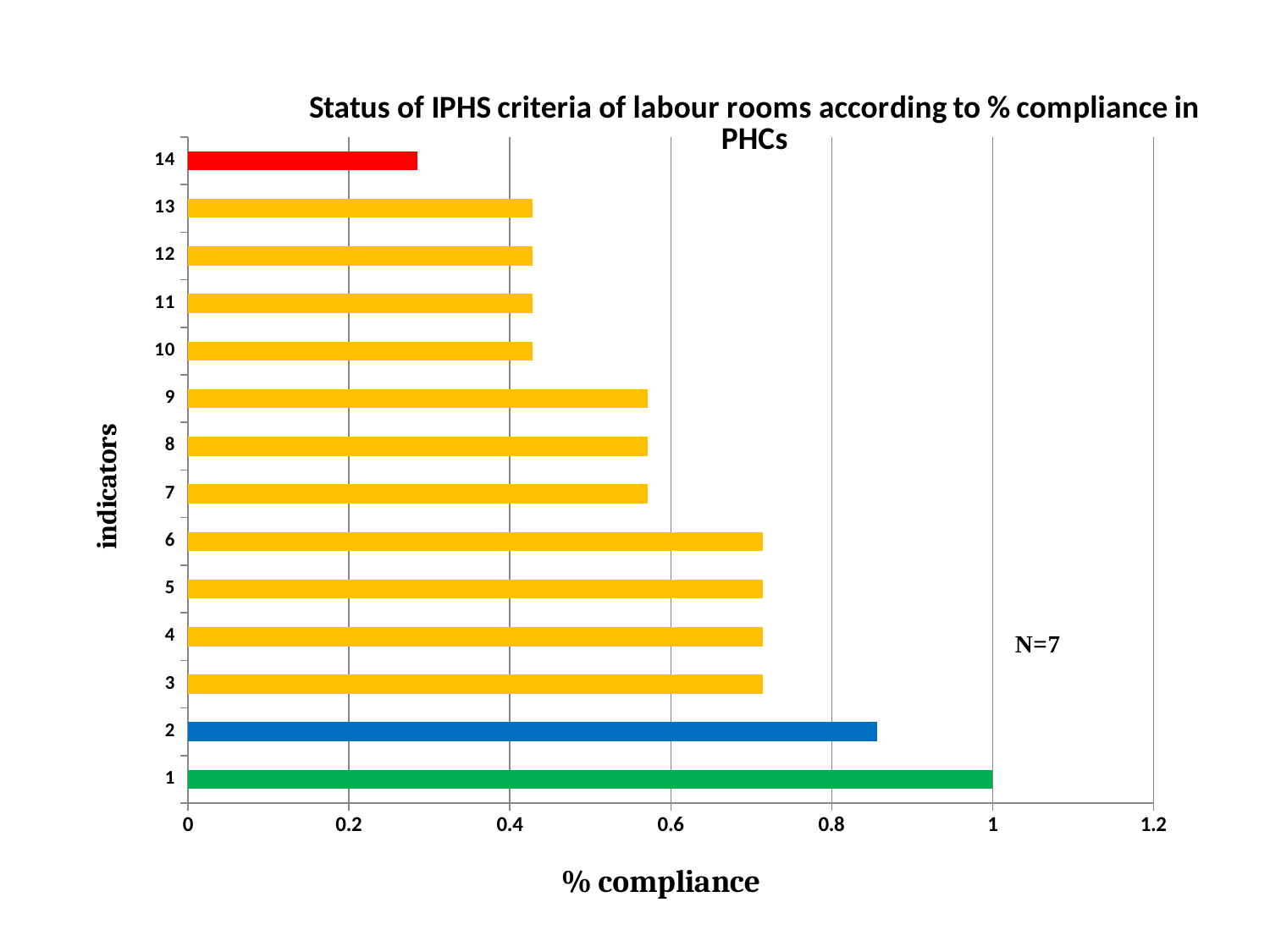
How many indicators are plotted on the chart? 14 What is the % compliance value for indicator 1? 1 What is the title of the chart? Status of IPHS criteria of labour rooms according to % compliance in PHCs Which indicator has the lowest % compliance? 14 What kind of chart is shown on the slide? bar chart Is the value for indicator 2 greater or less than 0.8? greater What is the label of the horizontal axis? % compliance Is the value for indicator 10 greater or less than 0.6? less Which indicator has the highest % compliance? 1 Is the value for indicator 14 greater or less than 0.4? less Which has a larger % compliance, indicator 9 or indicator 13? indicator 9